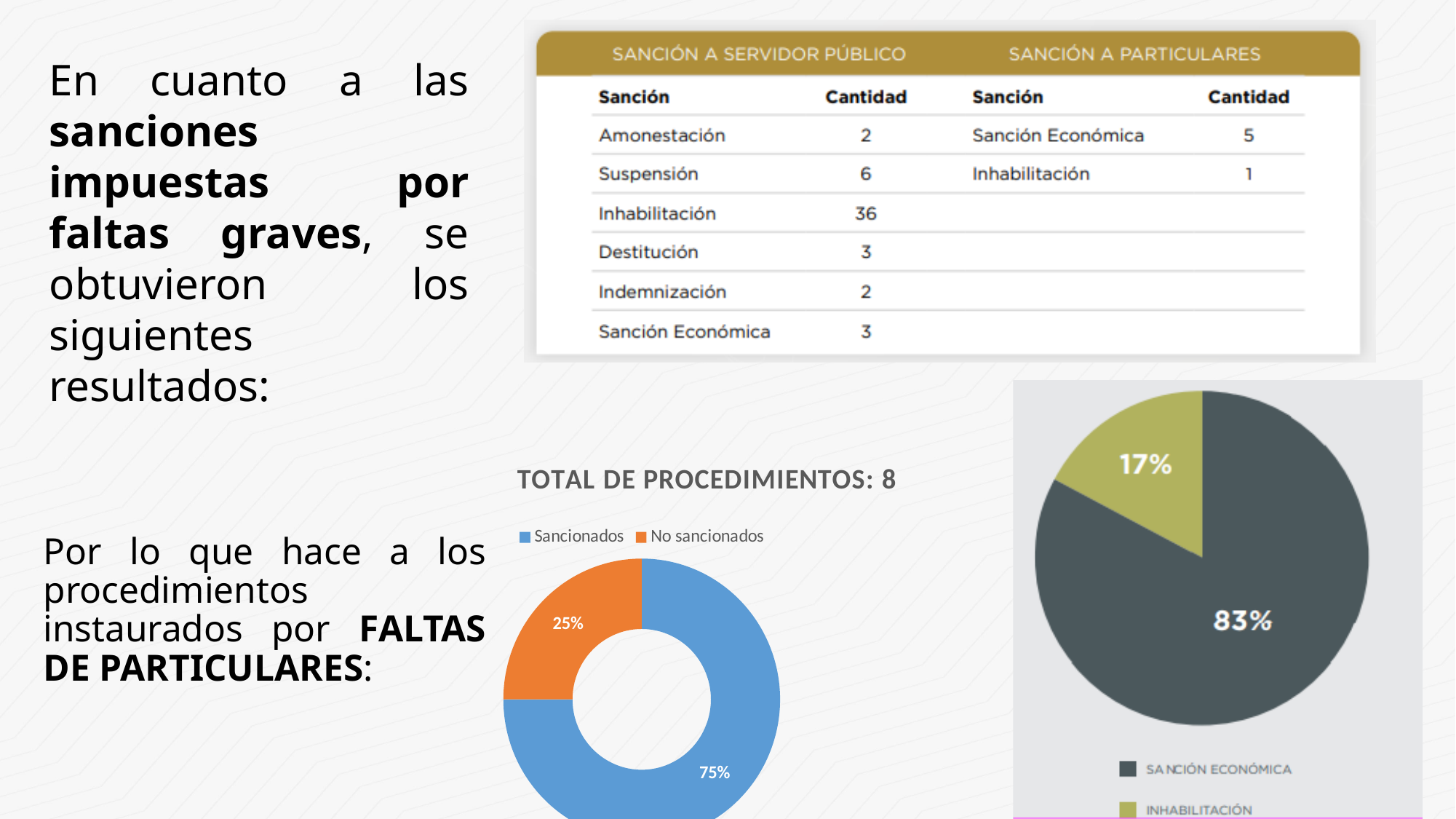
In the donut chart titled "TOTAL DE PROCEDIMIENTOS: 8", what percentage is shown for Sancionados? 75% In the donut chart titled "TOTAL DE PROCEDIMIENTOS: 8", what percentage is shown for No sancionados? 25% In the donut chart titled "TOTAL DE PROCEDIMIENTOS: 8", which category has the smaller share? No sancionados How many categories does the legend of the donut chart titled "TOTAL DE PROCEDIMIENTOS: 8" list? 2 In the donut chart titled "TOTAL DE PROCEDIMIENTOS: 8", which category has the larger share? Sancionados What kind of chart is the one titled "TOTAL DE PROCEDIMIENTOS: 8"? Donut (pie) chart In the pie chart at the bottom right of the slide, what percentage is shown for Sanción Económica? 83% In the pie chart at the bottom right of the slide, how many slices are there? 2 In the pie chart at the bottom right of the slide, which category has the largest share? Sanción Económica In the donut chart titled "TOTAL DE PROCEDIMIENTOS: 8", what is the difference in percentage points between Sancionados and No sancionados? 50 percentage points In the donut chart titled "TOTAL DE PROCEDIMIENTOS: 8", what colour represents No sancionados? Orange In the pie chart at the bottom right of the slide, what percentage is shown for Inhabilitación? 17%